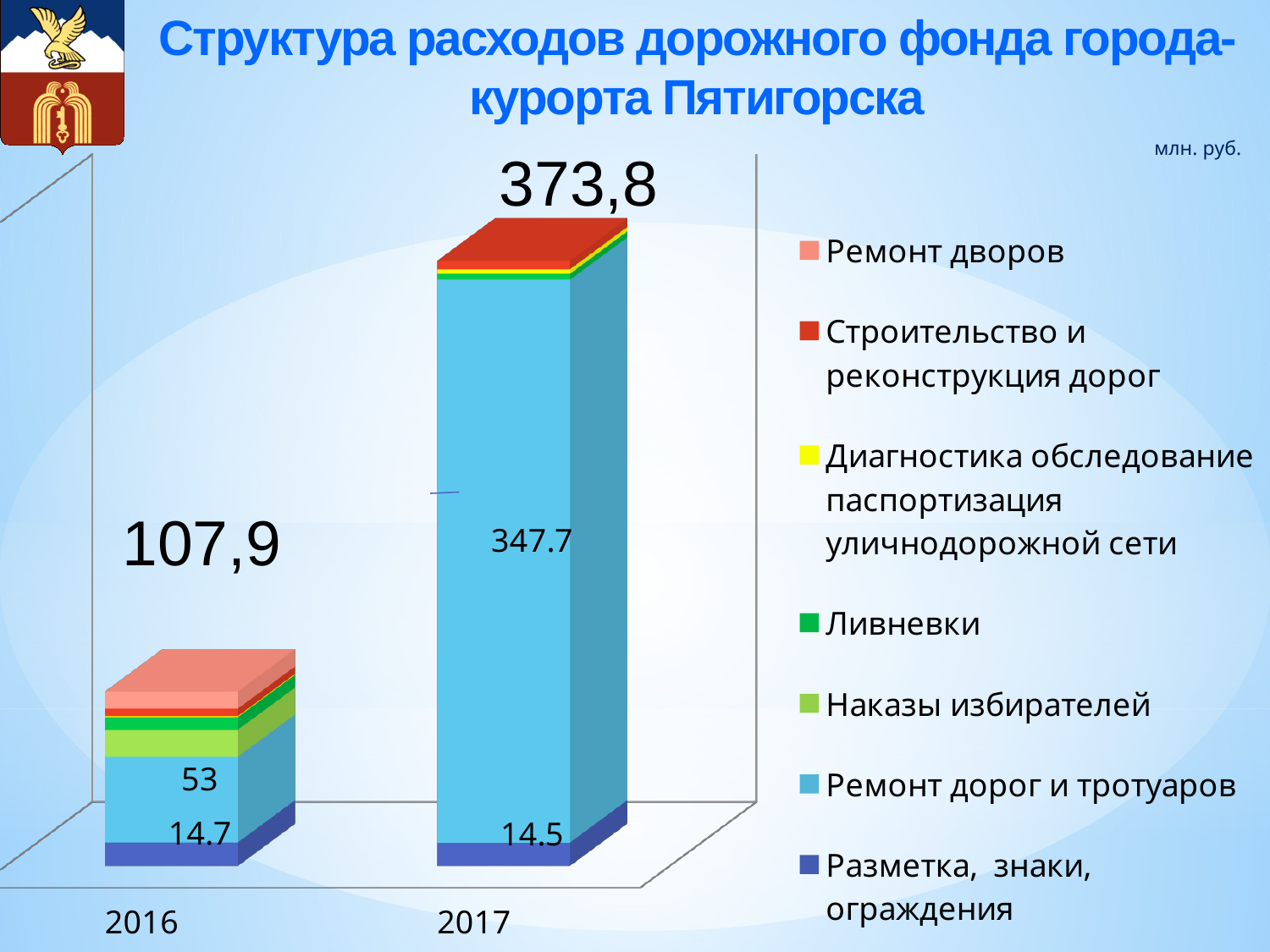
What is the value of 'Разметка, знаки, ограждения' for 2016? 14.7 What is the value of 'Разметка, знаки, ограждения' for 2017? 14.5 What unit of measurement is indicated on the slide for the chart values? млн. руб. What is the total value printed above the 2017 bar? 373,8 What is the value of 'Ремонт дорог и тротуаров' for 2017? 347.7 What is the total value printed above the 2016 bar? 107,9 Which year has the higher total expenditure, 2016 or 2017? 2017 What is the value of 'Ремонт дорог и тротуаров' for 2016? 53 How many years (categories) are shown on the x axis of the chart? 2 What type of chart is shown on the slide? stacked bar chart How many series does the chart legend list? 7 Does the total expenditure rise or fall from 2016 to 2017? rise